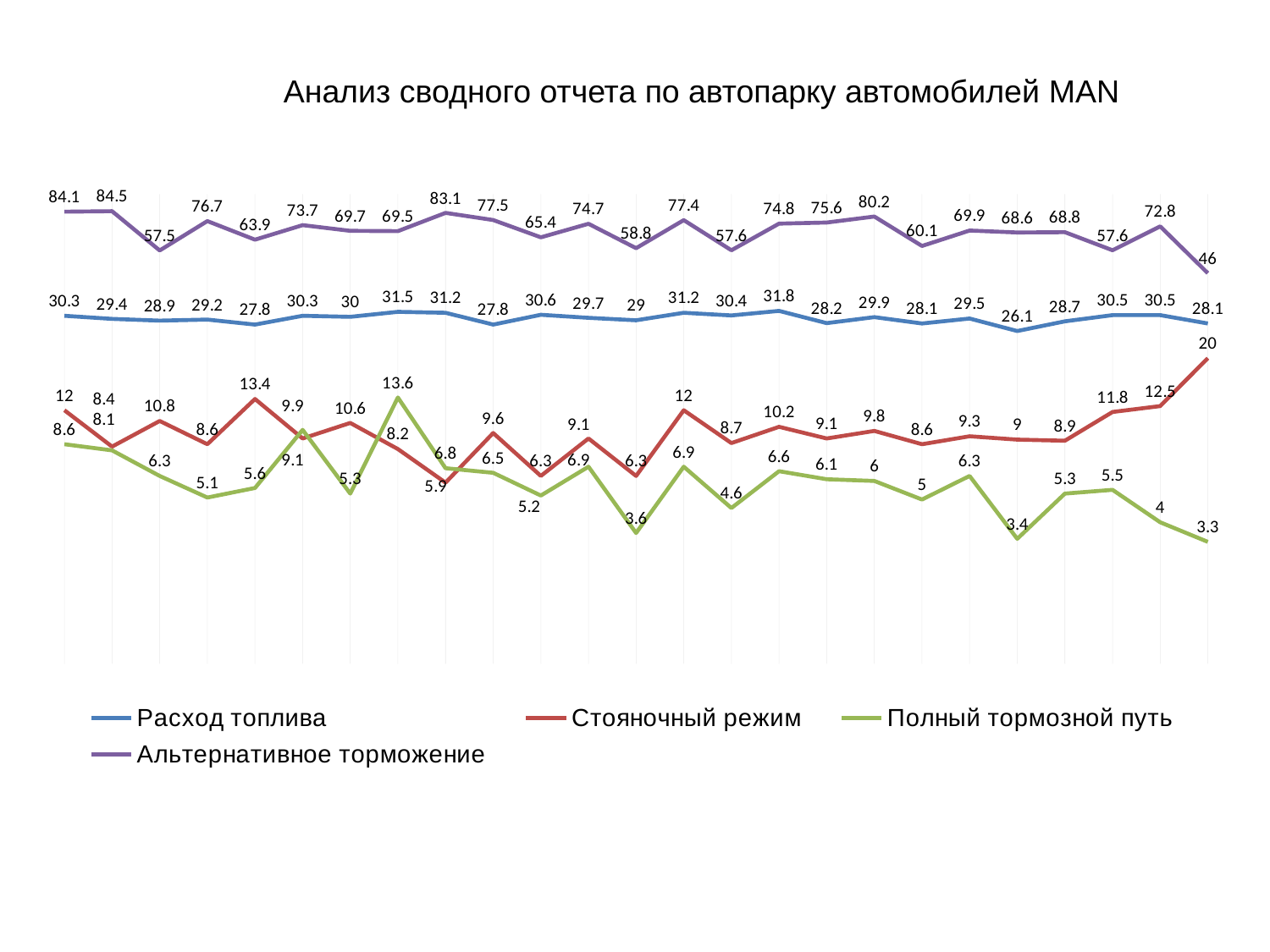
What is the highest value in the Полный тормозной путь series? 13.6 What is the last (rightmost) value of the Стояночный режим series? 20 What is the highest value in the Альтернативное торможение series? 84.5 What is the lowest value in the Альтернативное торможение series? 46 How many data points does the Расход топлива series have? 25 How many series does the legend list? 4 What is the highest value in the Стояночный режим series? 20 What is the difference between the first and last values of the Альтернативное торможение series (84.1 and 46)? 38.1 What is the lowest value in the Расход топлива series? 26.1 What kind of chart is shown on the slide? line chart What is the title of the chart? Анализ сводного отчета по автопарку автомобилей MAN What is the lowest value in the Полный тормозной путь series? 3.3